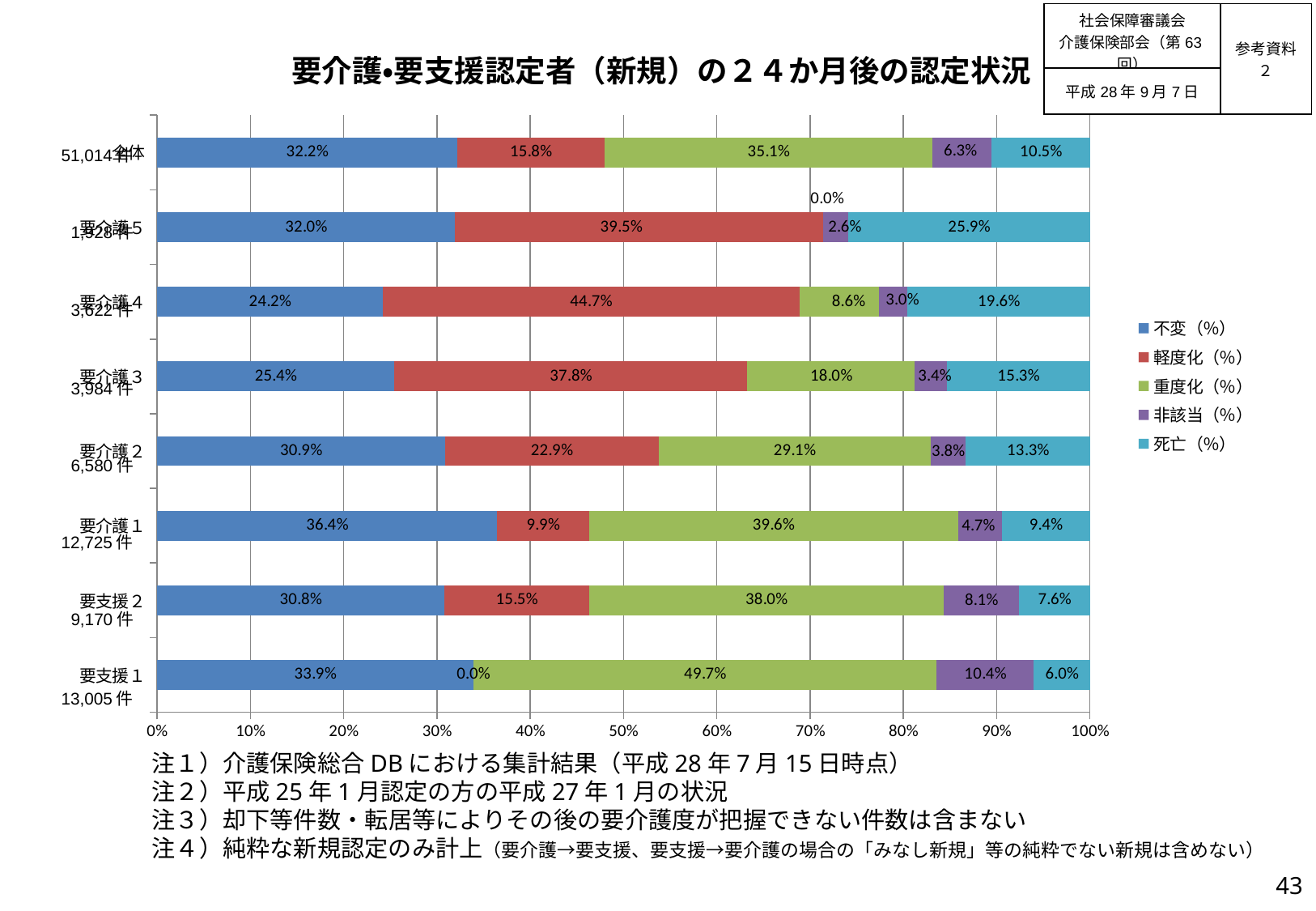
Which is larger, the 非該当（%） value for 要支援２ or for 要介護２? 要支援２ What is the 不変（%） value for 要介護１? 36.4% How many series does the legend list? 5 Which category has the highest 重度化（%） value? 要支援１ How many categories (bars) are plotted on the chart? 8 Which category has the lowest 死亡（%） value? 要支援１ What is the difference between the 軽度化（%） values for 要介護５ and 要介護１? 29.6% What is the 重度化（%） value for 要支援１? 49.7% What type of chart is shown on the slide? Stacked bar chart What is the 死亡（%） value for 要介護５? 25.9% What is the 軽度化（%） value for 要介護４? 44.7% Which series is shown in green in the legend? 重度化（%）